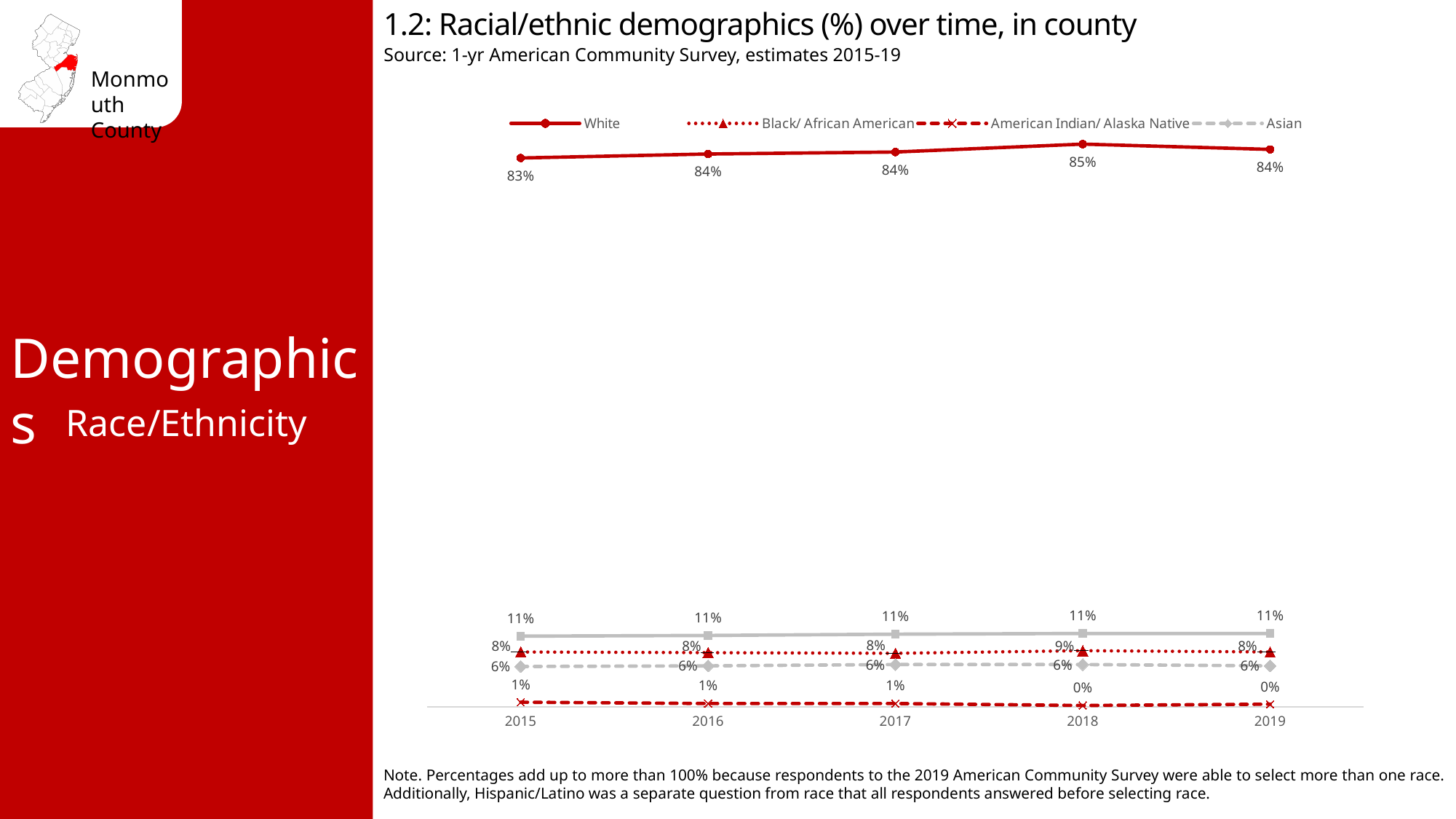
What is the value for American Indian/ Alaska Native in 2019? 0% What is the value for Black/ African American in 2018? 9% In 2016, which is larger: Black/ African American or Asian? Black/ African American What is the value for Asian in 2017? 6% In which year is the White series at its highest? 2018 What is the difference between the White value in 2018 and in 2015? 2% What is the title of the chart? 1.2: Racial/ethnic demographics (%) over time, in county What is the value for White in 2018? 85% In which year is the White series at its lowest? 2015 How many years are shown on the x axis? 5 How many series does the legend list? 4 What kind of chart is shown on the slide? line chart